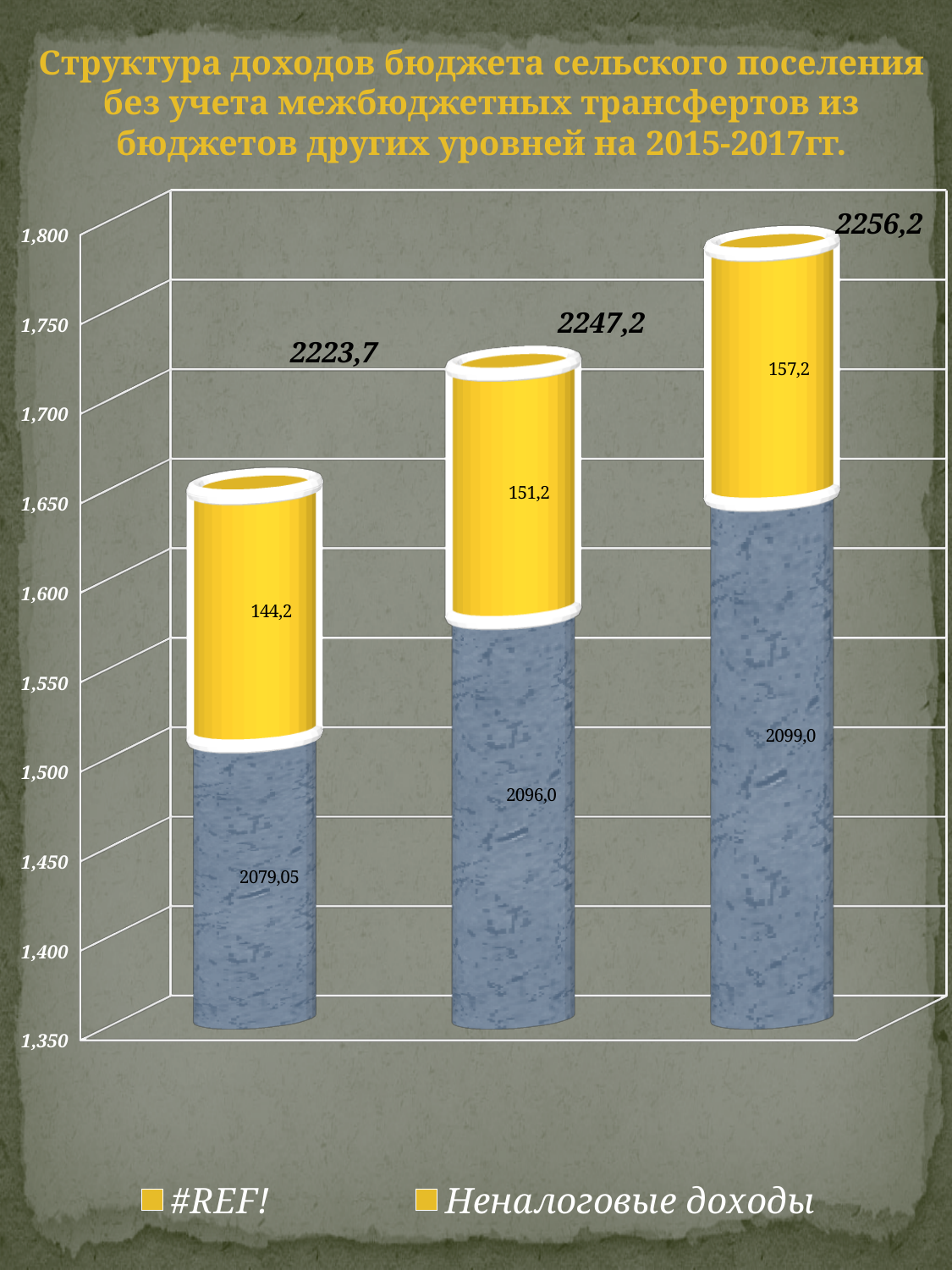
What is the value printed on the grey bottom segment of the rightmost bar? 2099,0 Which bar has the highest total value printed above it? The rightmost bar (2256,2) What is the value printed on the yellow top segment of the middle bar? 151,2 How many bars are plotted in the chart? 3 What total value is printed above the middle bar? 2247,2 What is the value printed on the yellow top segment of the leftmost bar? 144,2 What kind of chart is shown on the slide? Stacked bar chart Which is larger: the grey bottom segment of the middle bar or of the leftmost bar? The middle bar (2096,0) How many series does the legend list? 2 What is the difference between the yellow segment values of the rightmost bar (157,2) and the leftmost bar (144,2)? 13,0 Do the total values printed above the bars rise or fall from left to right? Rise What are the two entries shown in the legend? #REF! and Неналоговые доходы